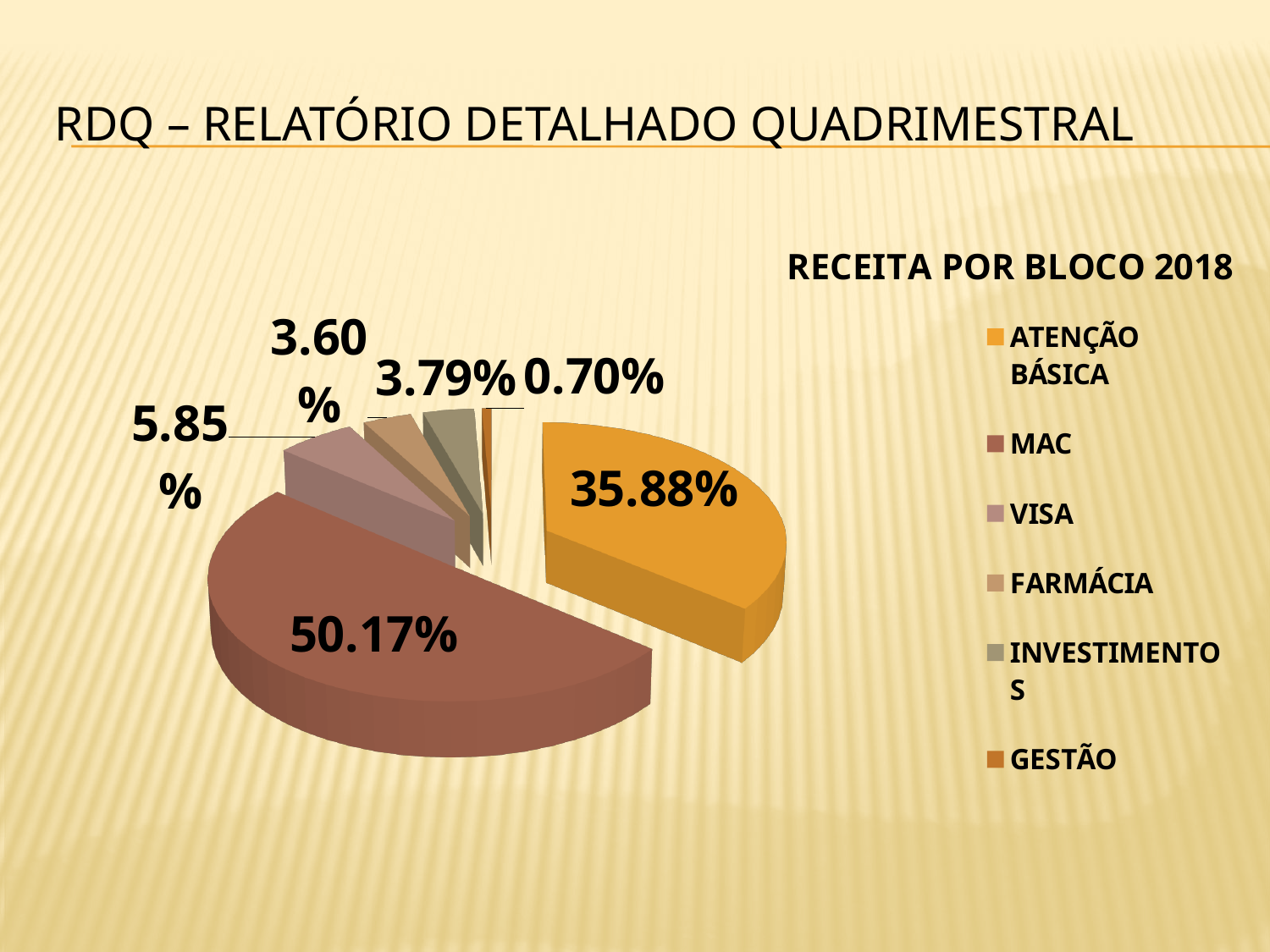
What is the title of the chart? RECEITA POR BLOCO 2018 Which is larger, the share for MAC or the share for ATENÇÃO BÁSICA? MAC How many categories does the legend of the pie chart list? 6 What share of the pie does MAC represent? 50.17% What share of the pie does VISA represent? 5.85% What kind of chart is shown on the slide? pie chart Which category has the smallest slice of the pie? GESTÃO What share of the pie does GESTÃO represent? 0.70% Which category has the largest slice of the pie? MAC What is the difference in percentage points between the MAC share and the ATENÇÃO BÁSICA share? 14.29 Which colour represents MAC in the pie chart? brown